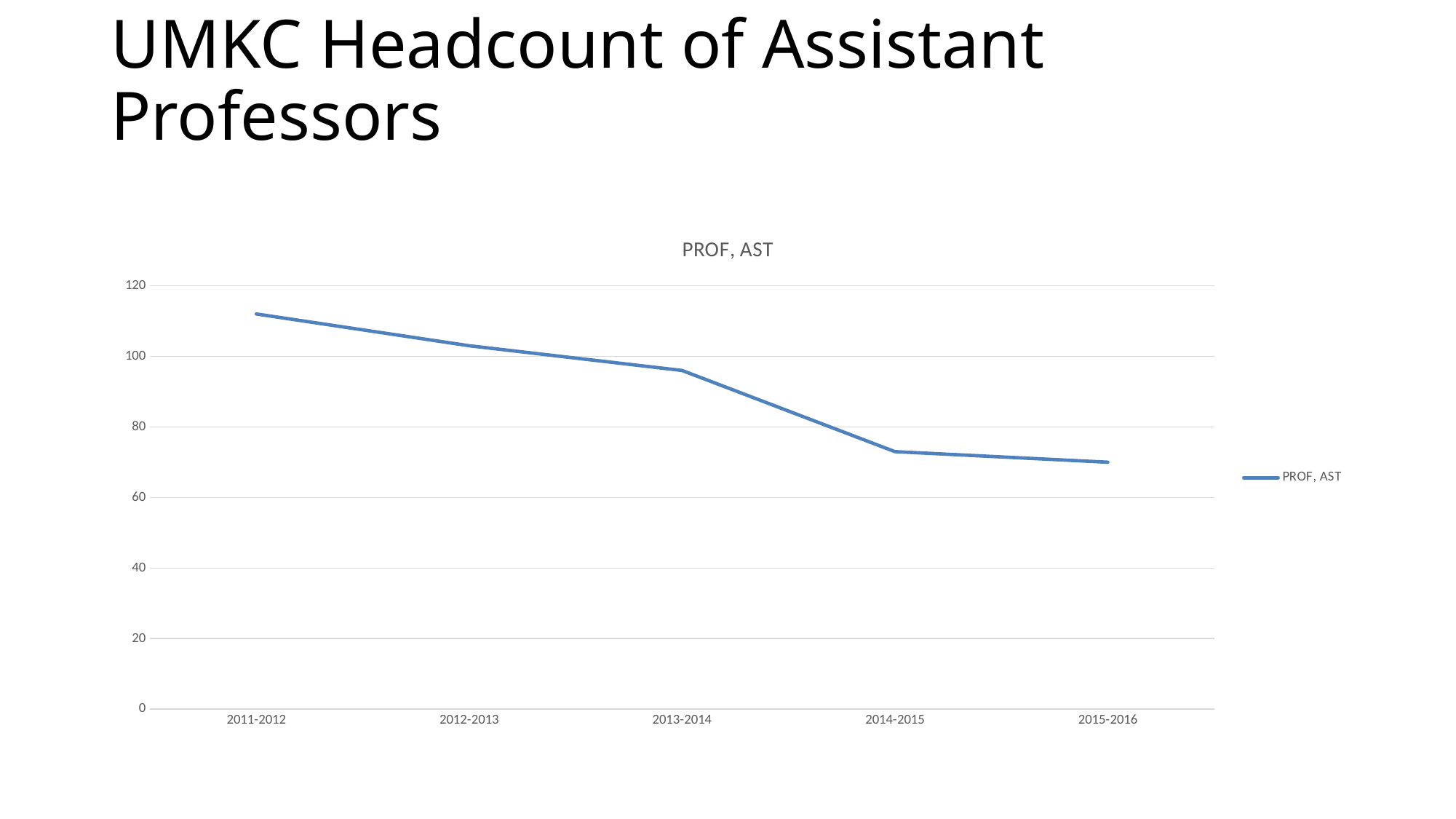
What is the title of the chart? PROF, AST Is the value for 2014-2015 greater or less than 80? less Do the values rise or fall from 2011-2012 to 2015-2016? fall Is the value for 2015-2016 greater or less than 60? greater What type of chart is shown on the slide? line chart Is the value for 2013-2014 greater or less than 100? less How many academic years are plotted on the x axis? 5 How many series does the legend list? 1 Which academic year has the highest headcount? 2011-2012 Which is larger, the value for 2012-2013 or the value for 2014-2015? 2012-2013 Which academic year has the lowest headcount? 2015-2016